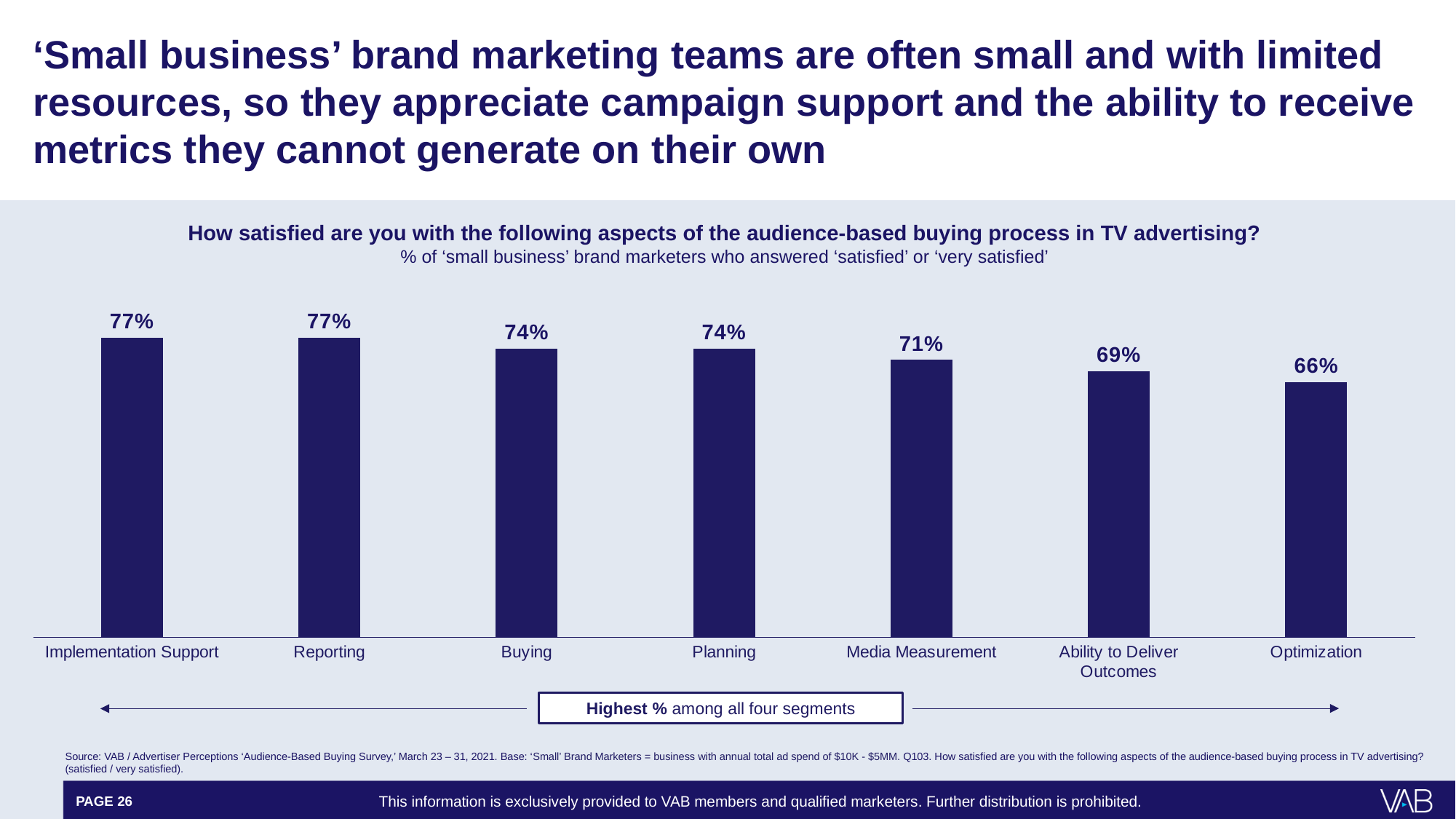
Which is larger, the value for Buying or the value for Ability to Deliver Outcomes? Buying What is the value shown for Media Measurement? 71% How many categories are shown on the chart? 7 What does the label box below the chart say? Highest % among all four segments What is the difference between the values for Reporting and Optimization? 11 percentage points What kind of chart is shown on the slide? Bar chart Which category has the lowest value on the chart? Optimization Do the values rise or fall moving from left to right along the x axis? Fall What is the value shown for Ability to Deliver Outcomes? 69% What percentage of 'small business' brand marketers are satisfied with Implementation Support? 77% What is the difference between the values for Planning and Media Measurement? 3 percentage points What is the value shown for Buying? 74%